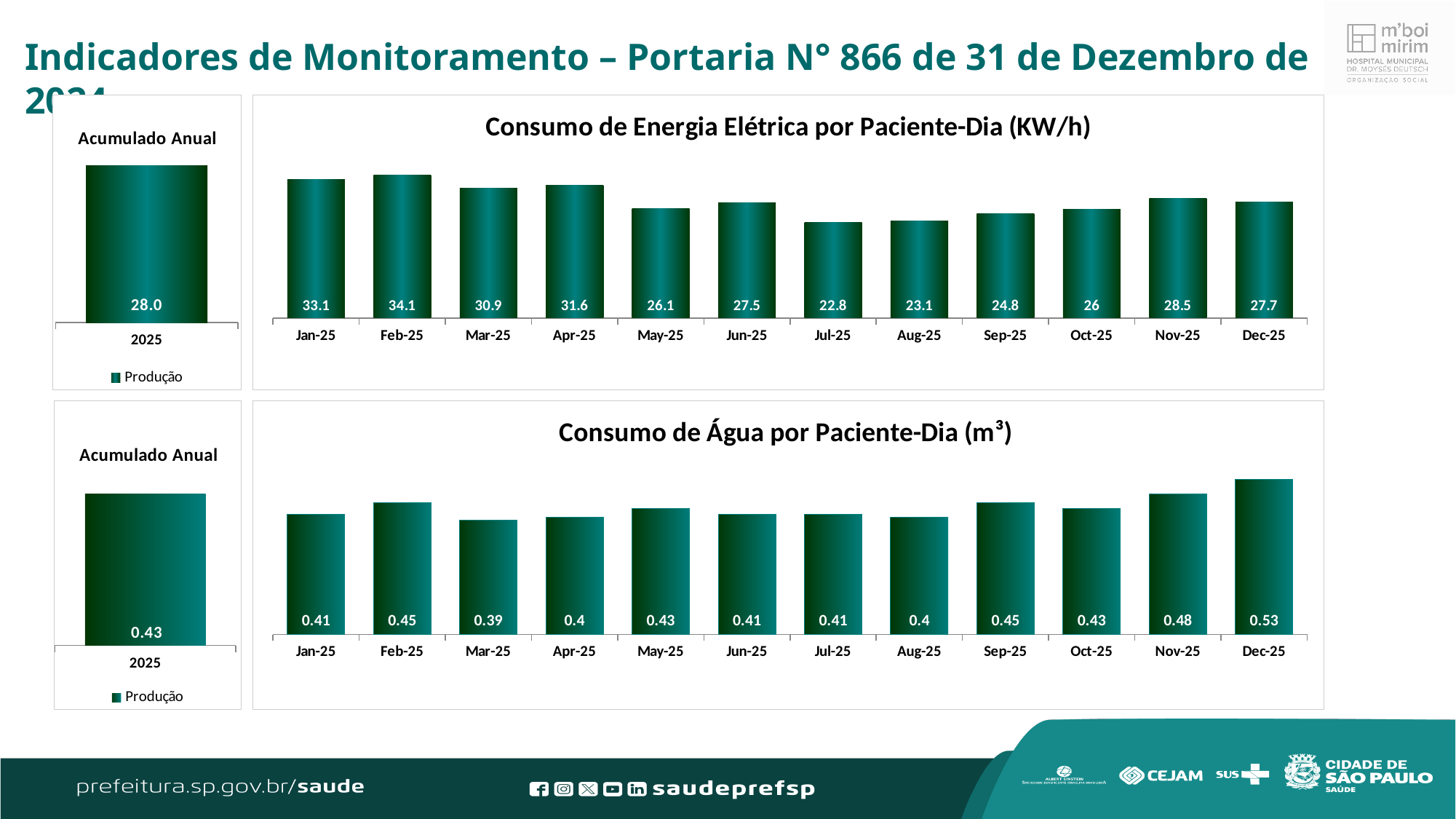
In the chart 'Consumo de Água por Paciente-Dia (m³)', what is the value for Nov-25? 0.48 In the chart 'Consumo de Energia Elétrica por Paciente-Dia (KW/h)', which month has the highest value? Feb-25 In the chart 'Consumo de Energia Elétrica por Paciente-Dia (KW/h)', how many months are plotted? 12 In the chart 'Consumo de Água por Paciente-Dia (m³)', which is larger, the value for Feb-25 or the value for Apr-25? Feb-25 In the chart 'Consumo de Água por Paciente-Dia (m³)', which month has the lowest value? Mar-25 In the chart 'Consumo de Água por Paciente-Dia (m³)', what is the difference between the Dec-25 and Mar-25 values? 0.14 What kind of chart is 'Consumo de Água por Paciente-Dia (m³)'? Bar chart In the upper-left 'Acumulado Anual' chart next to the energy chart, what is the value shown for 2025? 28.0 In the chart 'Consumo de Energia Elétrica por Paciente-Dia (KW/h)', what is the difference between the Feb-25 and Jul-25 values? 11.3 In the chart 'Consumo de Energia Elétrica por Paciente-Dia (KW/h)', what is the value for Jan-25? 33.1 In the chart 'Consumo de Água por Paciente-Dia (m³)', which month has the highest value? Dec-25 In the chart 'Consumo de Energia Elétrica por Paciente-Dia (KW/h)', which month has the lowest value? Jul-25